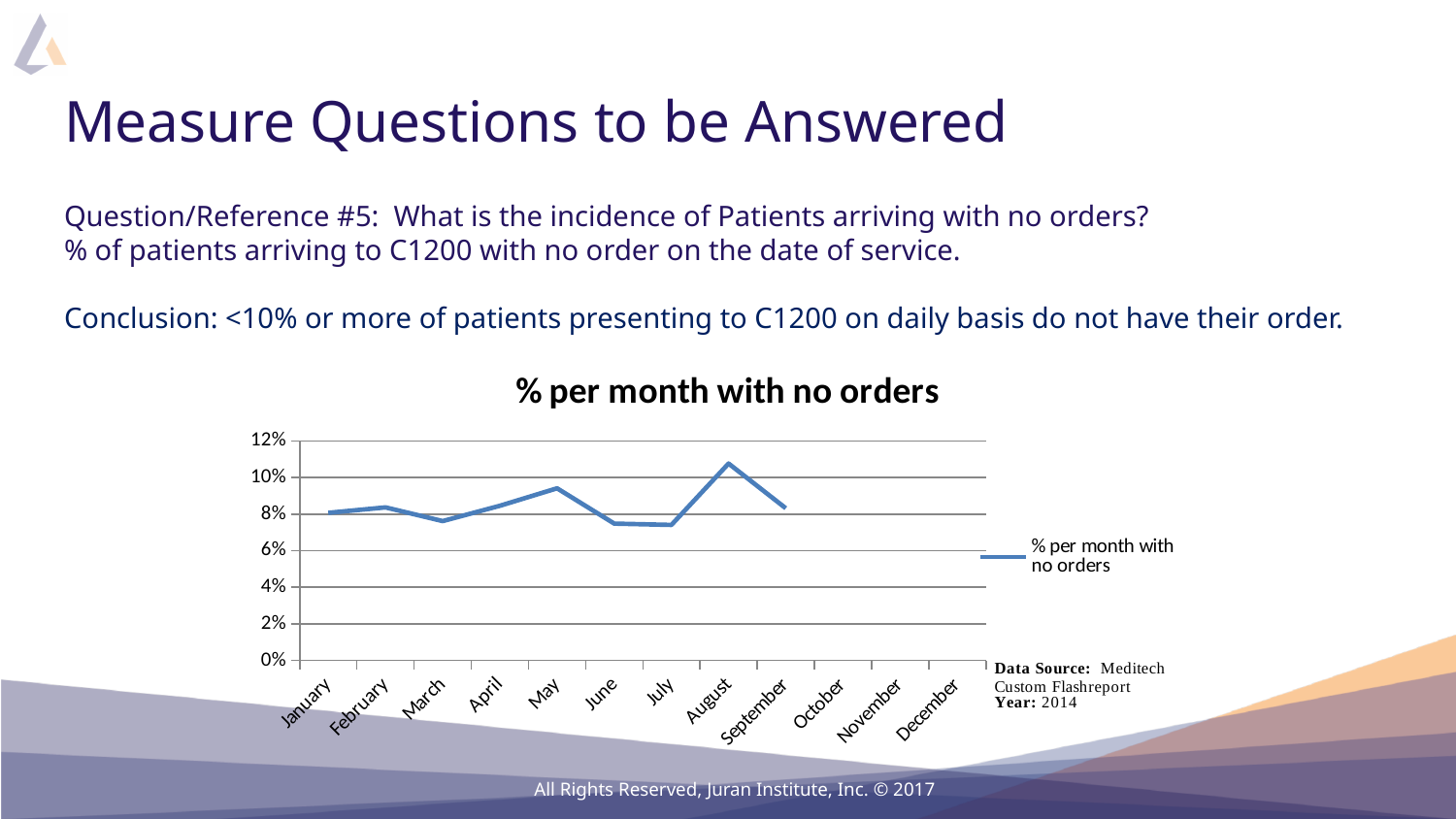
What kind of chart is shown on the slide? line chart What is the title of the chart? % per month with no orders How many month categories are labelled on the x axis? 12 Is the value for August greater or less than 10%? greater Is the value for July greater or less than 8%? less How many series does the chart legend list? 1 Which is larger, the value for May or the value for March? May Is the value for May greater or less than 8%? greater Does the line rise or fall from August to September? fall Which month has the highest value on the chart? August Which is larger, the value for August or the value for May? August